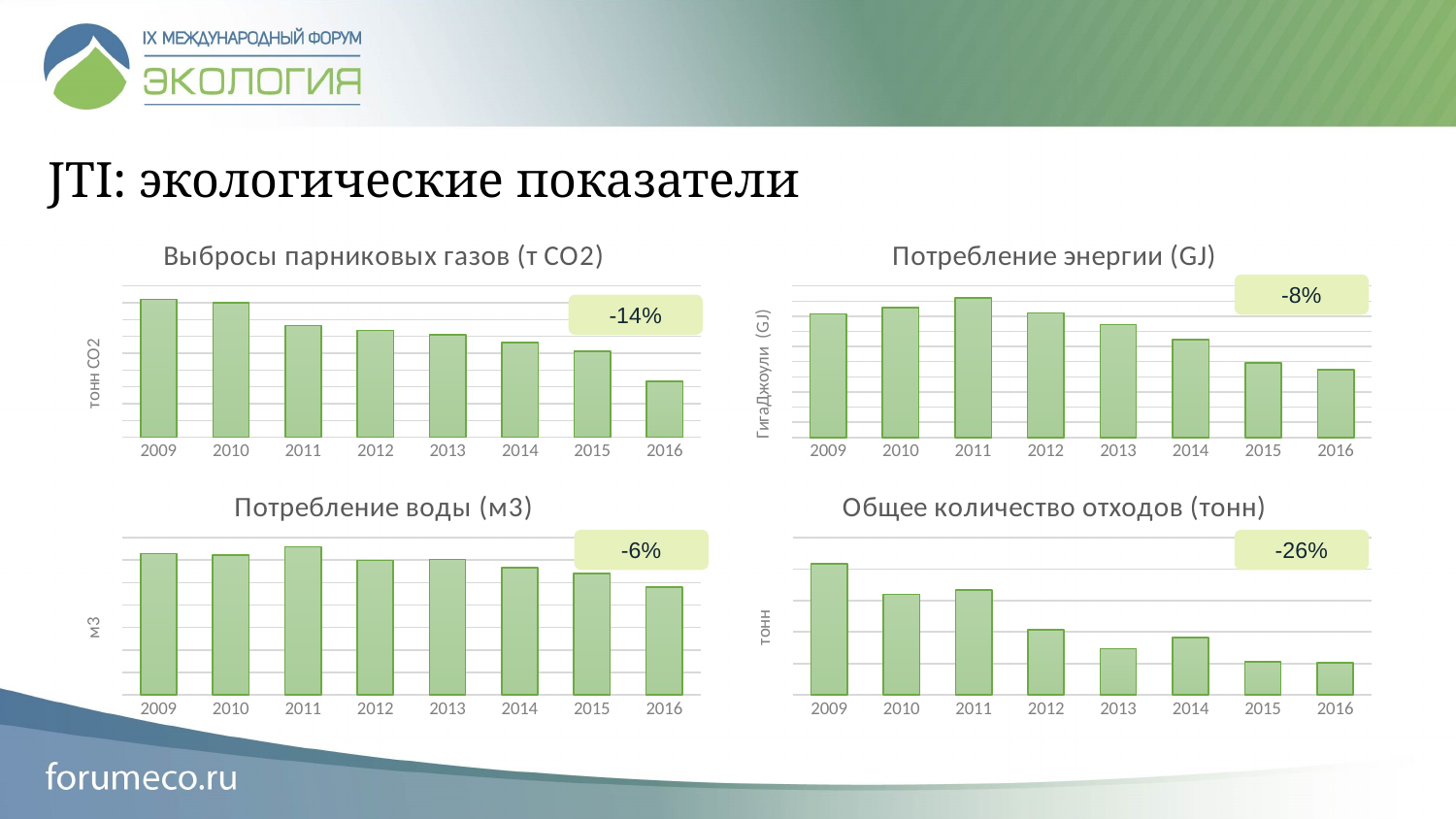
In the 'Общее количество отходов (тонн)' chart, which is larger, the value for 2012 or 2013? 2012 What percentage change is printed on the 'Общее количество отходов (тонн)' chart? -26% In the 'Выбросы парниковых газов (т CO2)' chart, which year has the lowest value? 2016 In the 'Потребление воды (м3)' chart, which year has the lowest value? 2016 How many years are shown on the x axis of the 'Потребление воды (м3)' chart? 8 In the 'Общее количество отходов (тонн)' chart, which year has the highest value? 2009 What percentage change is printed on the 'Потребление энергии (GJ)' chart? -8% In the 'Выбросы парниковых газов (т CO2)' chart, which year has the highest value? 2009 What kind of chart is the 'Выбросы парниковых газов (т CO2)' chart? bar chart In the 'Потребление энергии (GJ)' chart, which year has the highest value? 2011 In the 'Выбросы парниковых газов (т CO2)' chart, do the values generally rise or fall from 2009 to 2016? fall